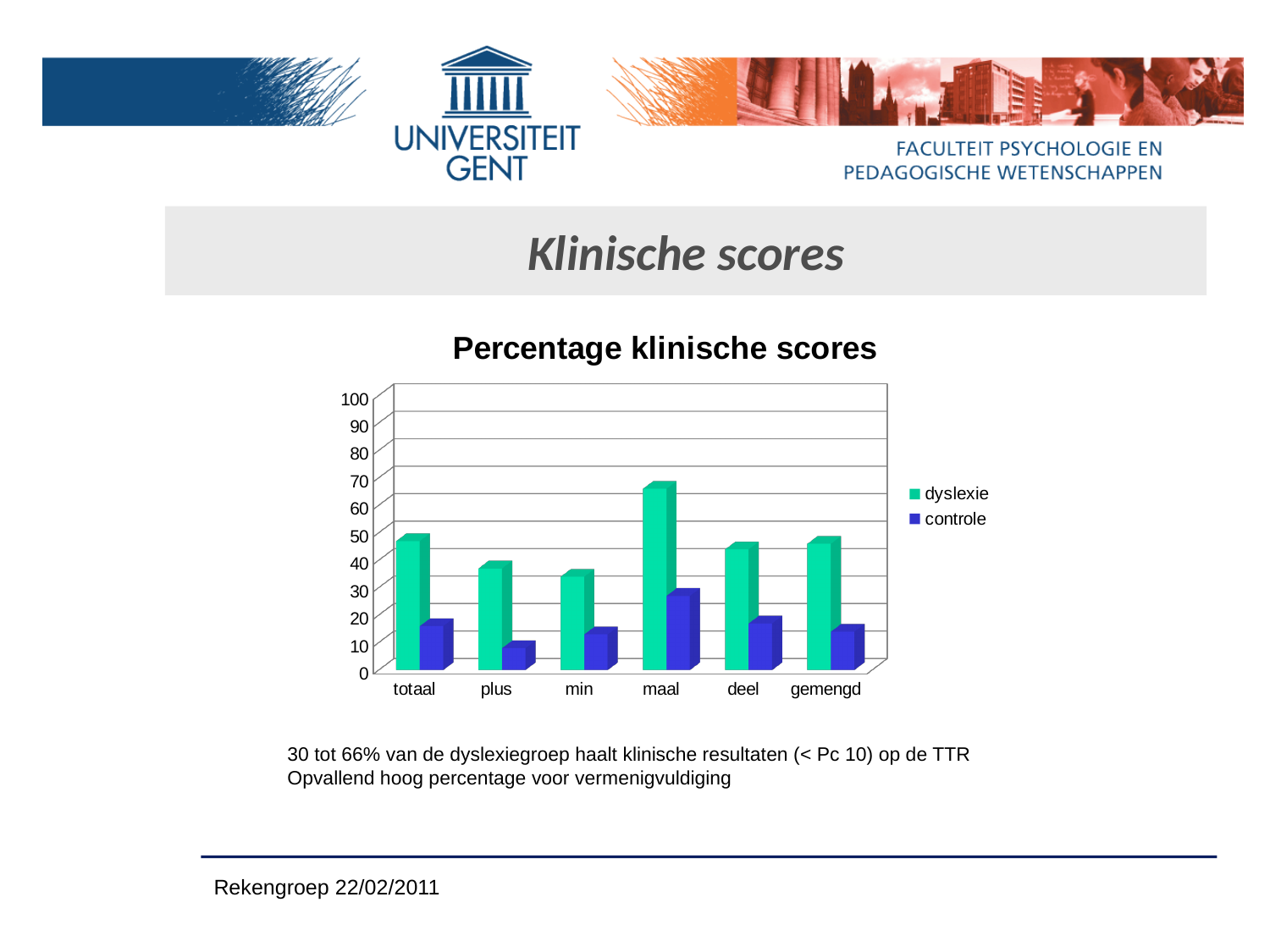
For the category totaal, which series has the larger value, dyslexie or controle? dyslexie Is the controle value for plus greater or less than 10? less What is the title of the chart? Percentage klinische scores Which category has the highest value for the controle series? maal How many series does the legend list? 2 Is the dyslexie value for totaal greater or less than 50? less Which category has the lowest value for the controle series? plus Which category has the highest value for the dyslexie series? maal What kind of chart is shown on the slide? bar chart Is the controle value for maal greater or less than 20? greater How many categories are shown on the x axis of the chart? 6